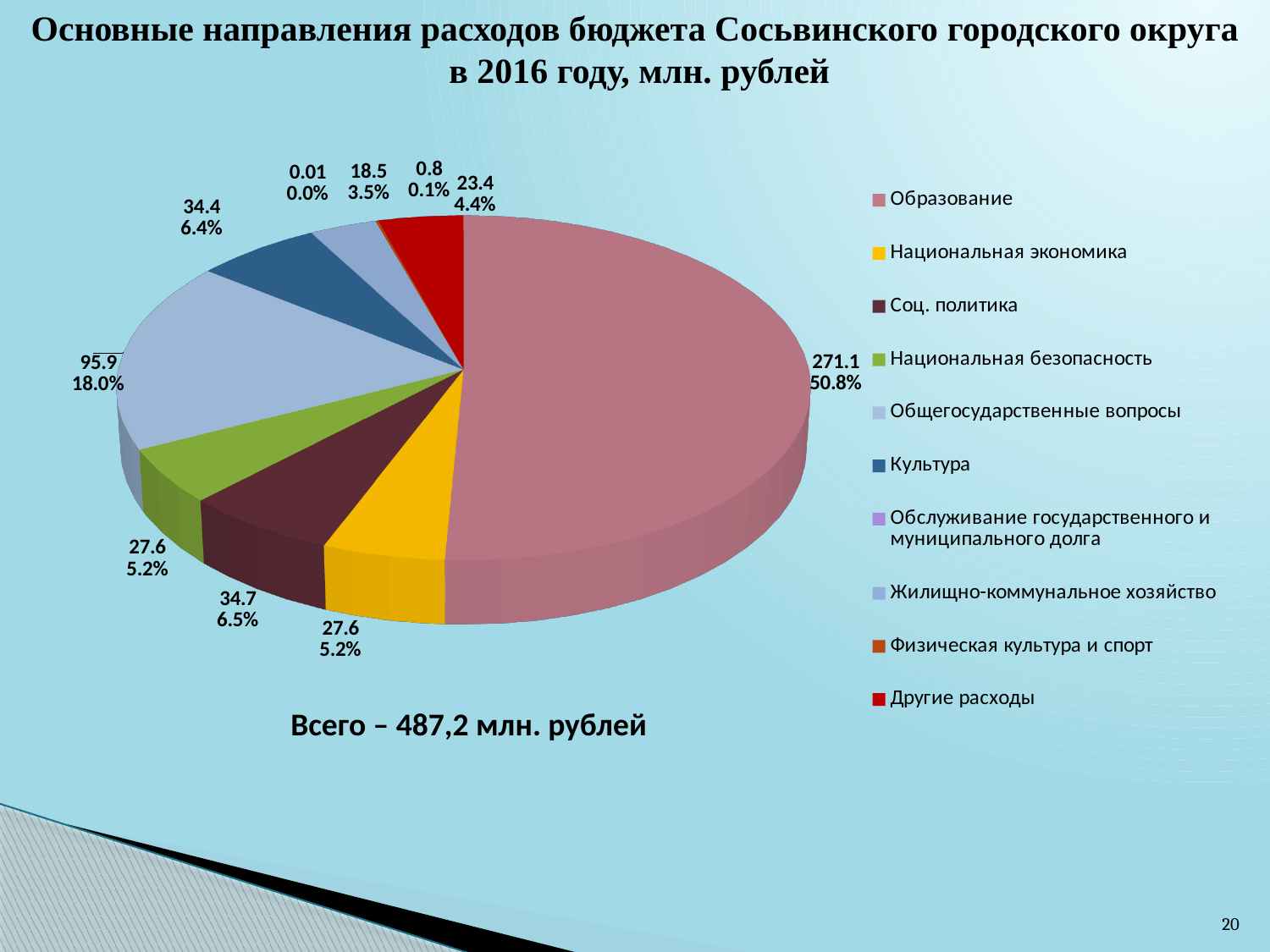
Which category has the smallest value? Обслуживание государственного и муниципального долга How many categories does the legend list? 10 What is the value for Образование? 271.1 What is the value for Жилищно-коммунальное хозяйство? 18.5 What total amount is stated below the chart? 487,2 млн. рублей What is the difference between the values for Общегосударственные вопросы and Другие расходы? 72.5 Which is larger, Соц. политика or Национальная безопасность? Соц. политика What share of the pie does Образование take? 50.8% What share of the pie does Культура take? 6.4% What kind of chart is shown on the slide? pie chart What is the value for Общегосударственные вопросы? 95.9 Which category has the largest slice? Образование